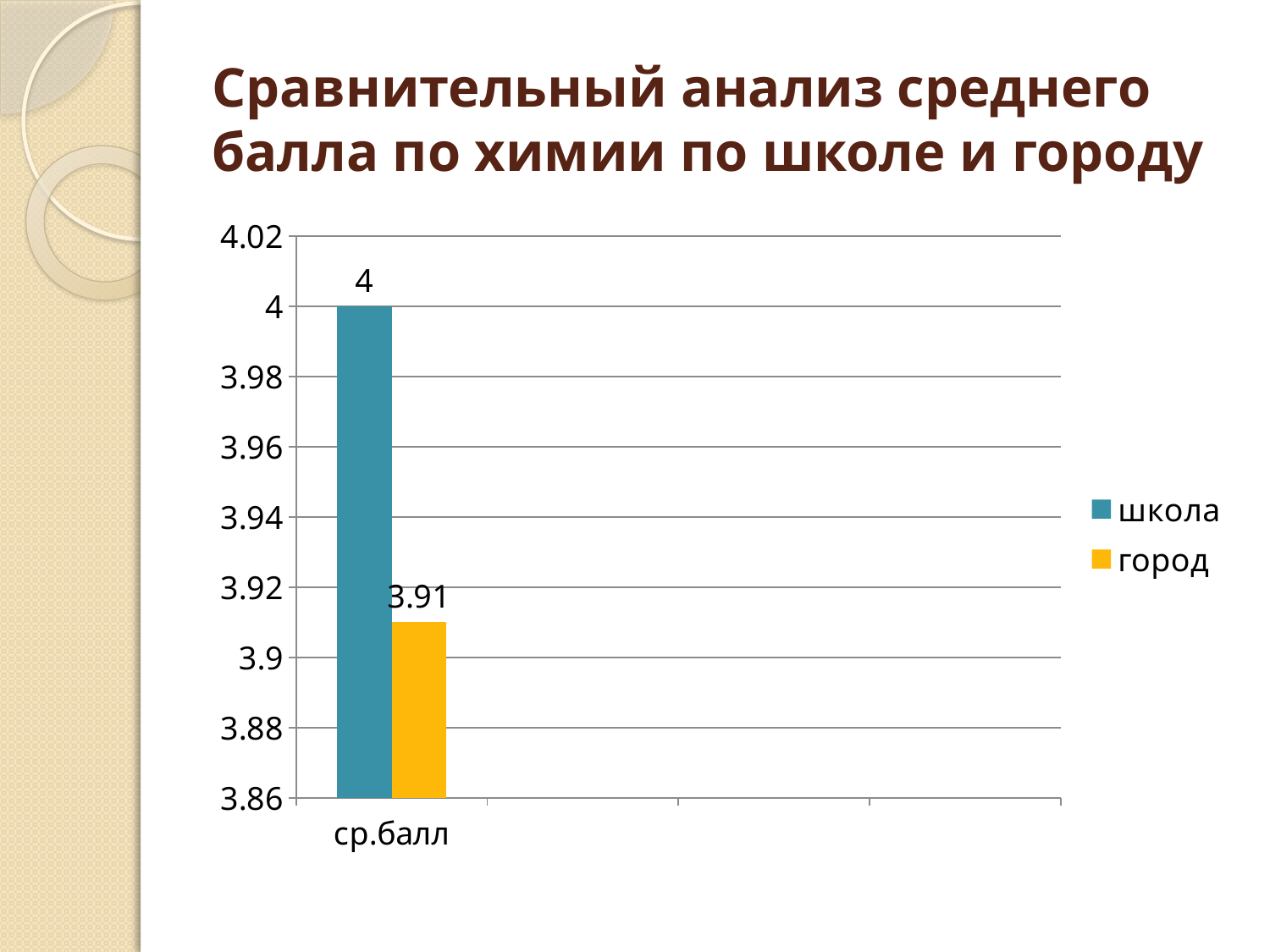
What is the label of the category on the x axis? ср.балл What is the value for город in the ср.балл category? 3.91 What is the value for школа in the ср.балл category? 4 How many series does the legend list? 2 Which series has the lowest value? город Which series has the higher value: школа or город? школа Is the value for школа greater or less than 3.98? greater How many categories are shown on the x axis? 1 Is the value for город greater or less than 3.92? less What colour is the bar for город? yellow What is the difference between the школа value and the город value? 0.09 What kind of chart is shown on the slide? bar chart